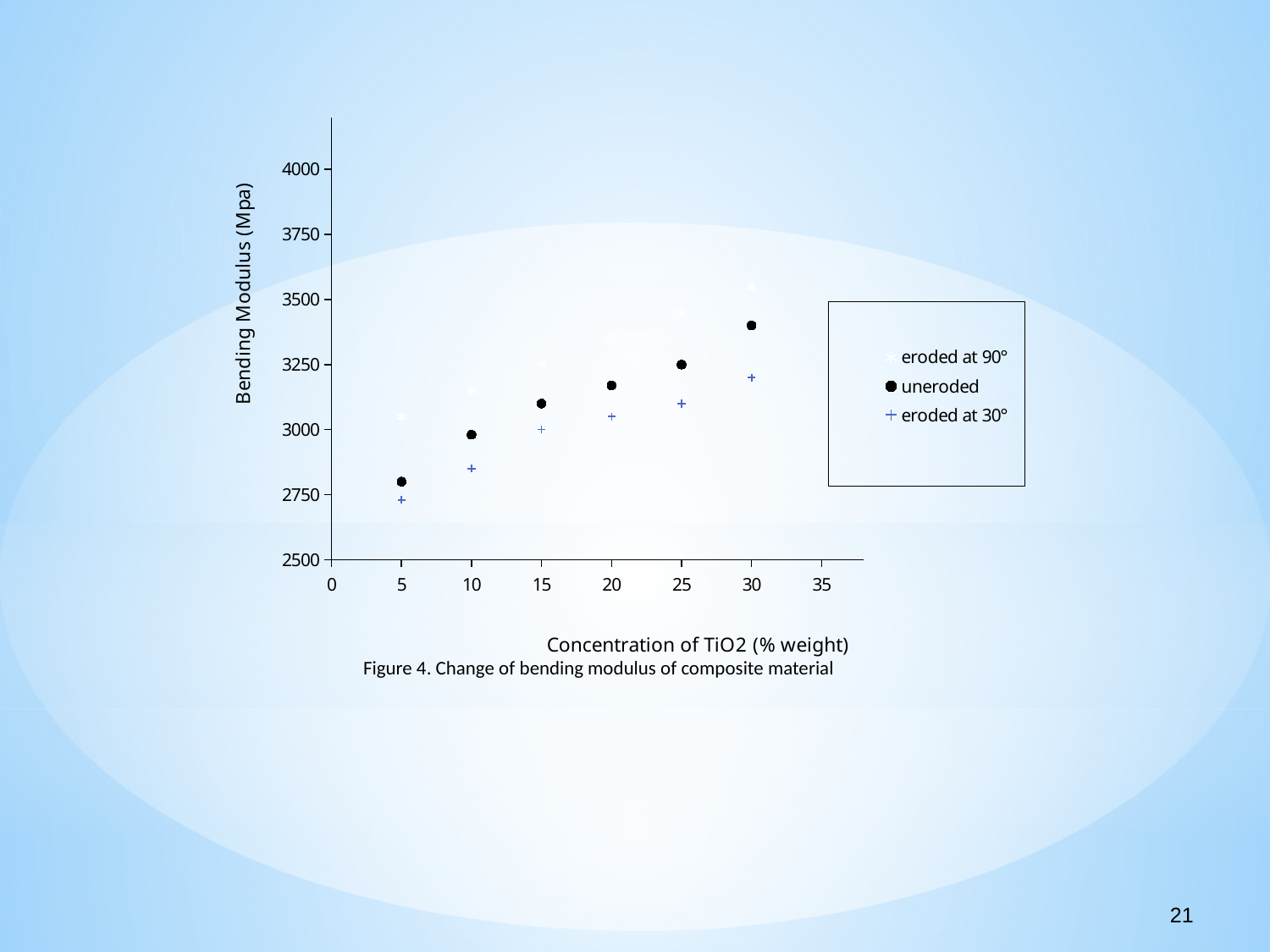
Is the value for the eroded at 90° series at a concentration of 30 greater or less than 3250? greater Is the value for the uneroded series at a concentration of 30 greater or less than 3250? greater Is the value for the eroded at 30° series at a concentration of 10 greater or less than 3000? less What kind of chart is shown on the slide? scatter chart Which series has the highest bending modulus at a concentration of 20? eroded at 90° Does the bending modulus of the uneroded series rise or fall as the concentration of TiO2 increases? rise How many data points are plotted for the uneroded series? 6 What is the title of the x axis? Concentration of TiO2 (% weight) At a concentration of 30, which series has the larger bending modulus: uneroded or eroded at 30°? uneroded How many series does the legend list? 3 What is the title of the y axis? Bending Modulus (Mpa)